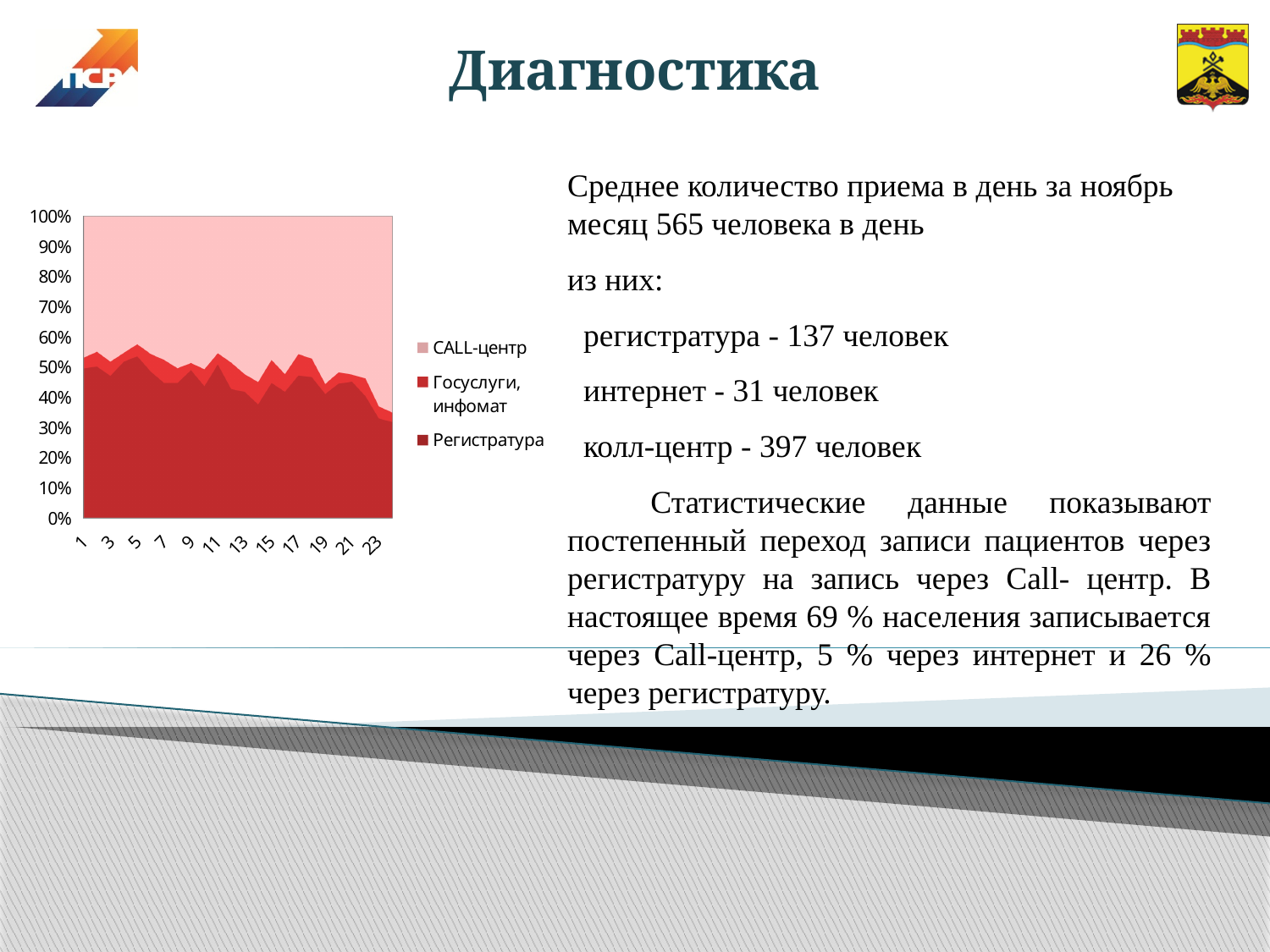
Is the share of CALL-центр at point 23 greater or less than 50%? greater What kind of chart is shown on the slide? area chart Which series has the largest share at point 23? CALL-центр What is the highest value shown on the y axis of the chart? 100% Does the share of Регистратура rise or fall along the x axis from 1 to 23? fall Is the share of Регистратура at point 1 greater or less than 40%? greater Which series is listed last in the chart legend? Регистратура Is the share of Регистратура at point 23 greater or less than 40%? less Which series has the smallest share across the chart? Госуслуги, инфомат Does the share of CALL-центр rise or fall along the x axis from 1 to 23? rise Which series is listed first in the chart legend? CALL-центр How many series does the chart legend list? 3